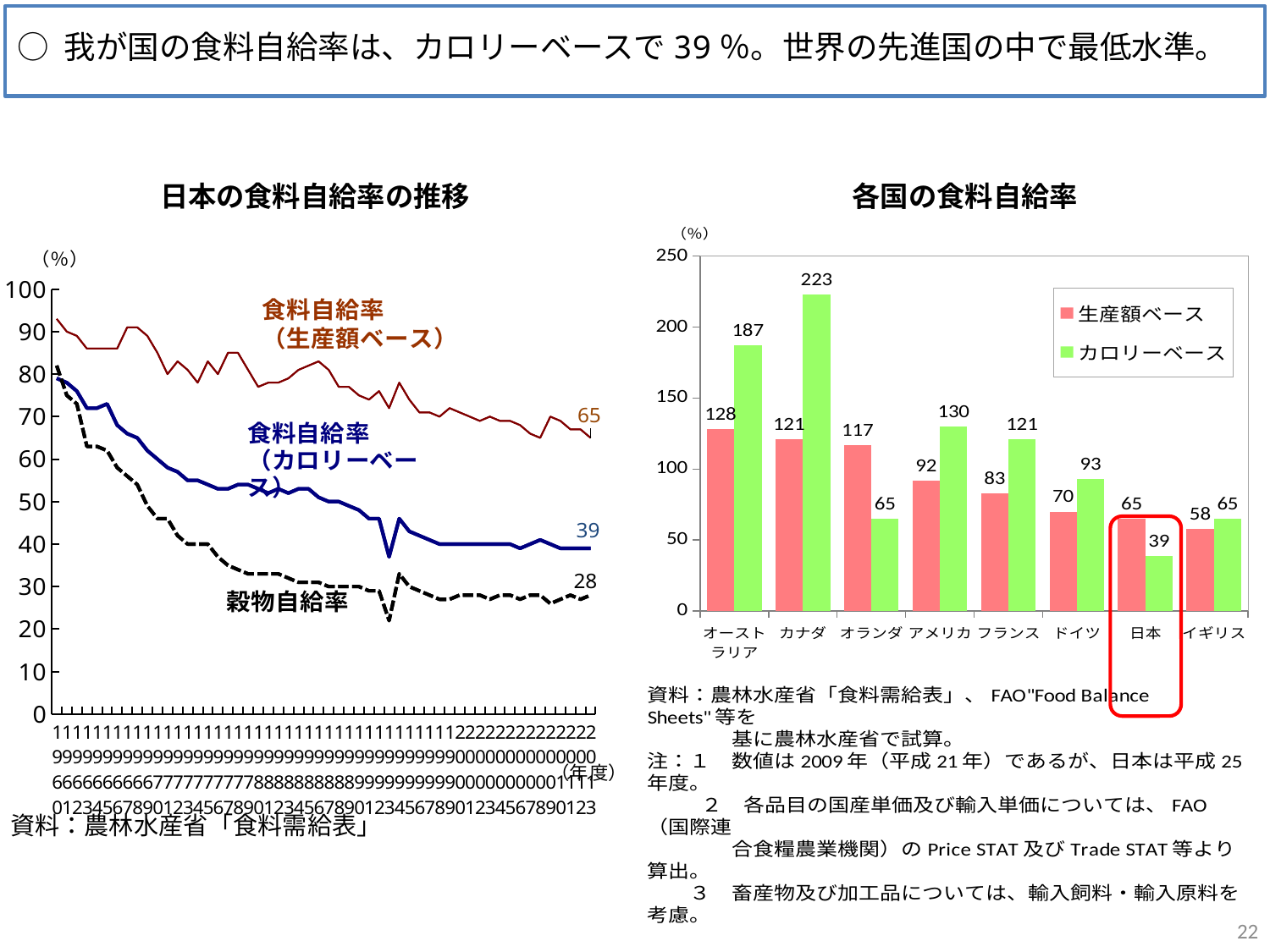
What kind of chart is the one titled 日本の食料自給率の推移? line chart In the chart titled 日本の食料自給率の推移, does the 食料自給率（生産額ベース） line generally rise or fall over time? fall In the chart titled 各国の食料自給率, how many series does the legend list? 2 In the chart titled 各国の食料自給率, what is the カロリーベース value for 日本? 39 What kind of chart is the one titled 各国の食料自給率? bar chart In the chart titled 各国の食料自給率, which country has the lowest 生産額ベース value? イギリス In the chart titled 各国の食料自給率, which country has the highest カロリーベース value? カナダ In the chart titled 日本の食料自給率の推移, what is the final labelled value of the 食料自給率（カロリーベース） line? 39 In the chart titled 各国の食料自給率, what is the difference between the カロリーベース values for カナダ and 日本? 184 In the chart titled 各国の食料自給率, what is the 生産額ベース value for オーストラリア? 128 In the chart titled 各国の食料自給率, which is larger for オランダ: the 生産額ベース value or the カロリーベース value? 生産額ベース In the chart titled 各国の食料自給率, how many countries are shown on the x axis? 8